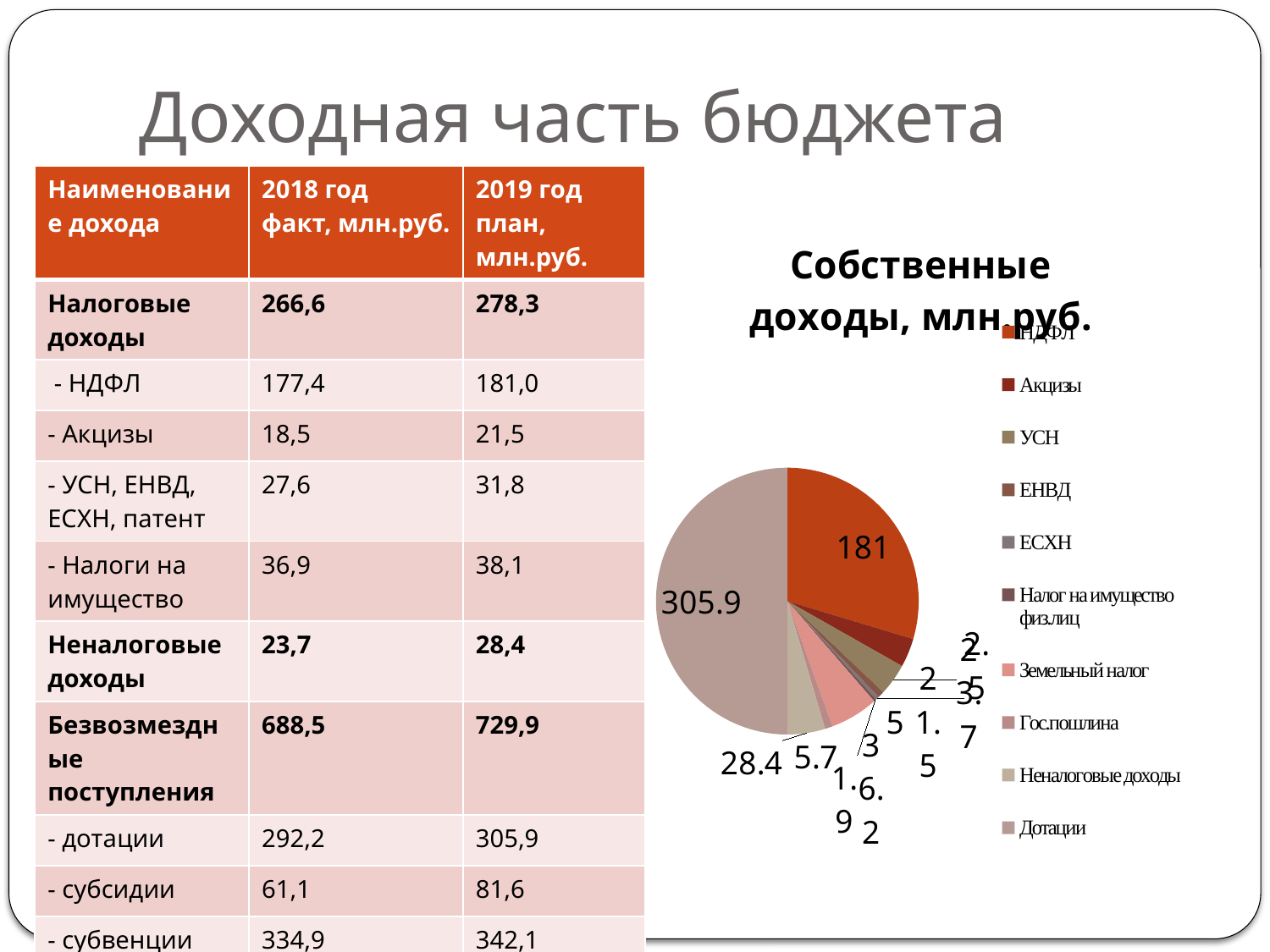
How many entries does the legend of the pie chart list? 10 What kind of chart is shown on the slide? Pie chart In the pie chart, what is the value for НДФЛ? 181 What is the title of the pie chart? Собственные доходы, млн.руб. In the pie chart, what is the difference between the values for Дотации and НДФЛ? 124.9 In the pie chart, what is the value for Дотации? 305.9 In the pie chart, which is larger: НДФЛ or Неналоговые доходы? НДФЛ In the pie chart, which is larger: Дотации or НДФЛ? Дотации Which category has the largest slice in the pie chart? Дотации Which legend entry is listed first in the pie chart's legend? НДФЛ In the pie chart, what is the difference between the values for НДФЛ and Неналоговые доходы? 152.6 In the pie chart, what is the value for Неналоговые доходы? 28.4